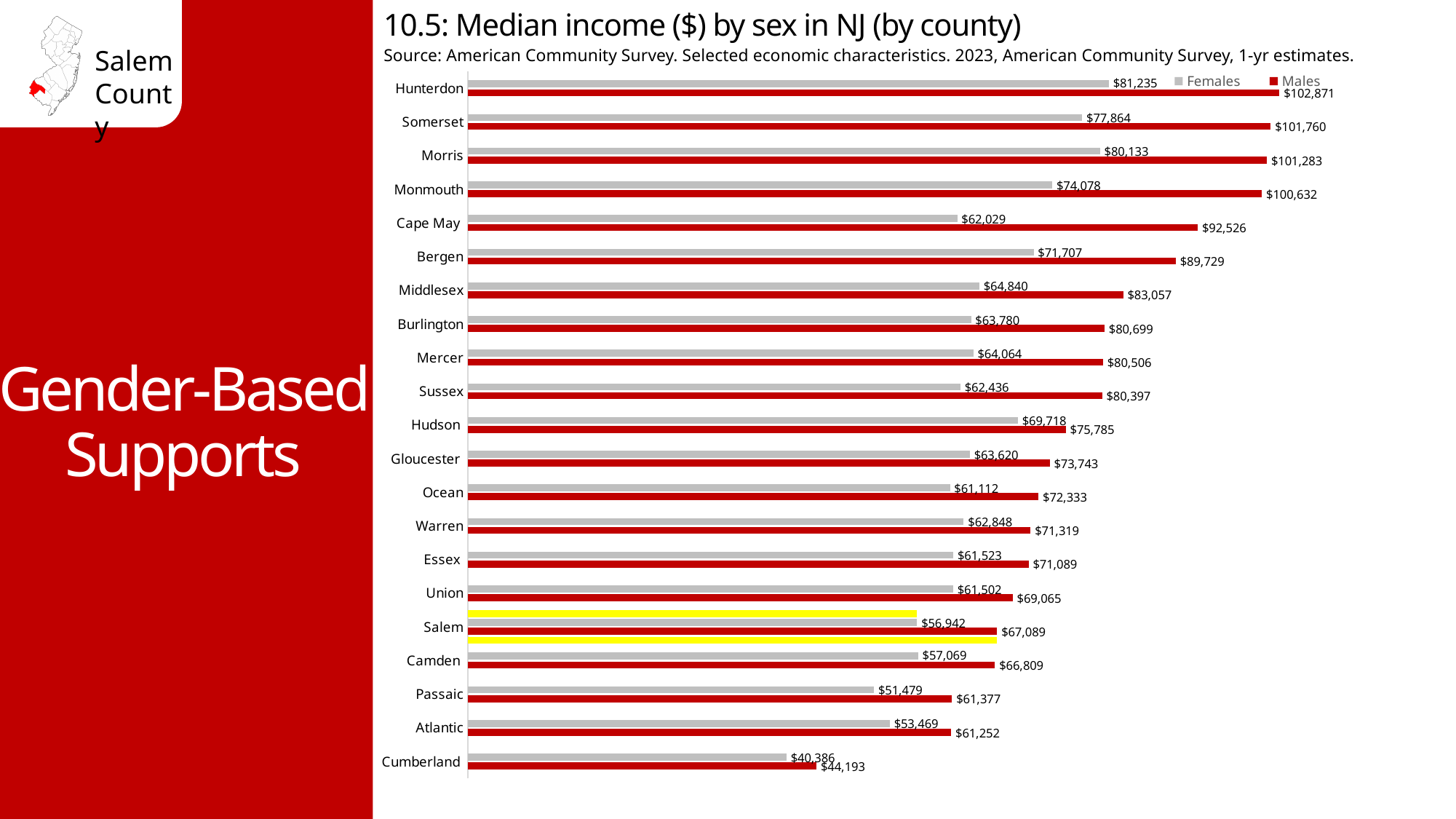
What is the difference between male and female median income in Hunterdon? $21,636 How many counties are shown in the chart? 21 What is the difference between male and female median income in Salem County? $10,147 What is the median income for females in Salem County? $56,942 What is the median income for males in Cape May? $92,526 What type of chart is shown on the slide? Bar chart What is the median income for females in Hudson? $69,718 What is the median income for males in Salem County? $67,089 Which is larger, the female median income in Bergen or in Monmouth? Monmouth How many series does the legend list? 2 Which county has the lowest median income for females? Cumberland Which county has the highest median income for males? Hunterdon